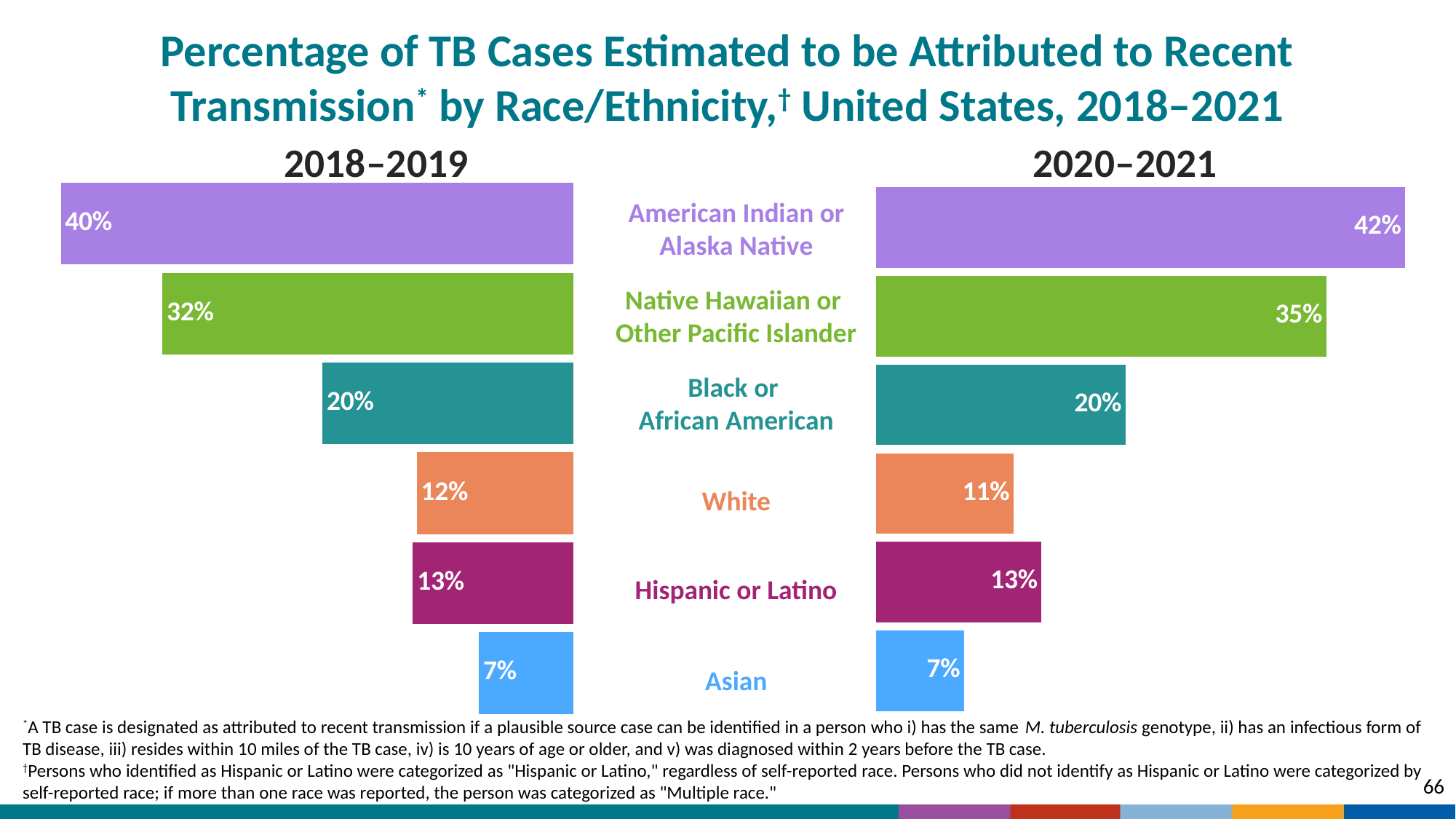
What is the difference between the 2020–2021 and 2018–2019 values for Native Hawaiian or Other Pacific Islander? 3% Is the value for American Indian or Alaska Native higher in the 2018–2019 chart or the 2020–2021 chart? 2020–2021 What type of chart is used on this slide? Bar chart In the 2018–2019 chart, which race/ethnicity group has the highest percentage? American Indian or Alaska Native In the 2020–2021 chart, which race/ethnicity group has the lowest percentage? Asian What colour is the bar for Asian in both charts? Blue How many race/ethnicity categories are shown in the 2018–2019 chart? 6 In the 2020–2021 chart, what is the value for Native Hawaiian or Other Pacific Islander? 35% In the 2020–2021 chart, what is the value for White? 11% In the 2018–2019 chart, what is the difference between the values for American Indian or Alaska Native and Native Hawaiian or Other Pacific Islander? 8% In the 2018–2019 chart, which is larger, the value for White or the value for Hispanic or Latino? Hispanic or Latino In the 2018–2019 chart, what percentage of TB cases is attributed to recent transmission for American Indian or Alaska Native persons? 40%